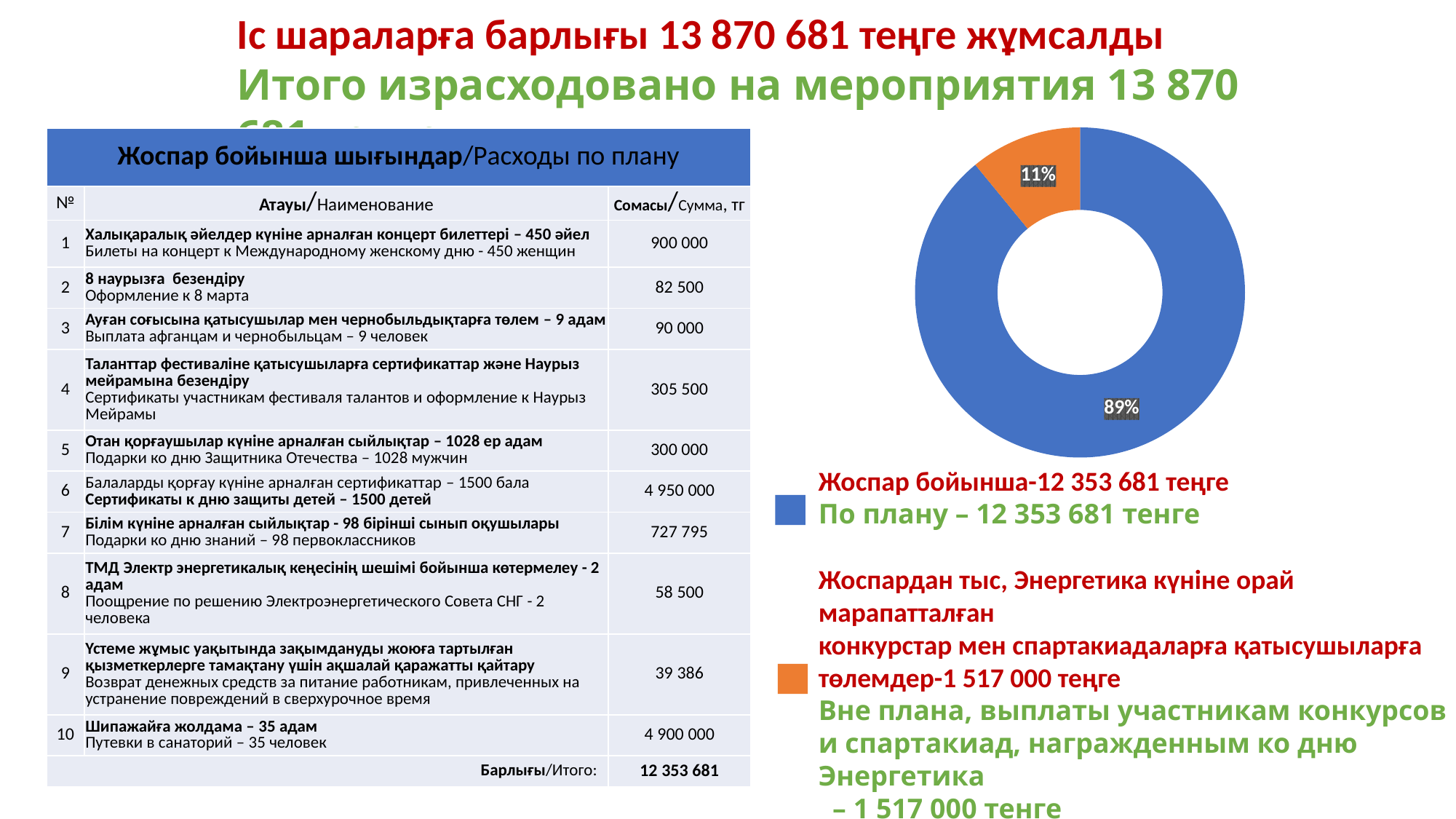
What is the difference in percentage points between the blue slice and the orange slice of the doughnut chart? 78 Which slice of the doughnut chart is the smallest? the orange slice (11%) What percentage is shown on the blue slice of the doughnut chart? 89% What amount in tenge does the legend give for the orange slice ('Вне плана')? 1 517 000 тенге Which is larger in the doughnut chart, the blue slice or the orange slice? the blue slice Is the value of the orange slice in the doughnut chart greater or less than 50%? less Which slice of the doughnut chart is the largest? the blue slice (89%) What percentage is shown on the orange slice of the doughnut chart? 11% How many slices does the doughnut chart have? 2 What amount in tenge does the legend give for the blue slice ('По плану')? 12 353 681 тенге What kind of chart is shown on the right side of the slide? doughnut chart What share of the doughnut chart does the 'По плану' (planned) category take? 89%